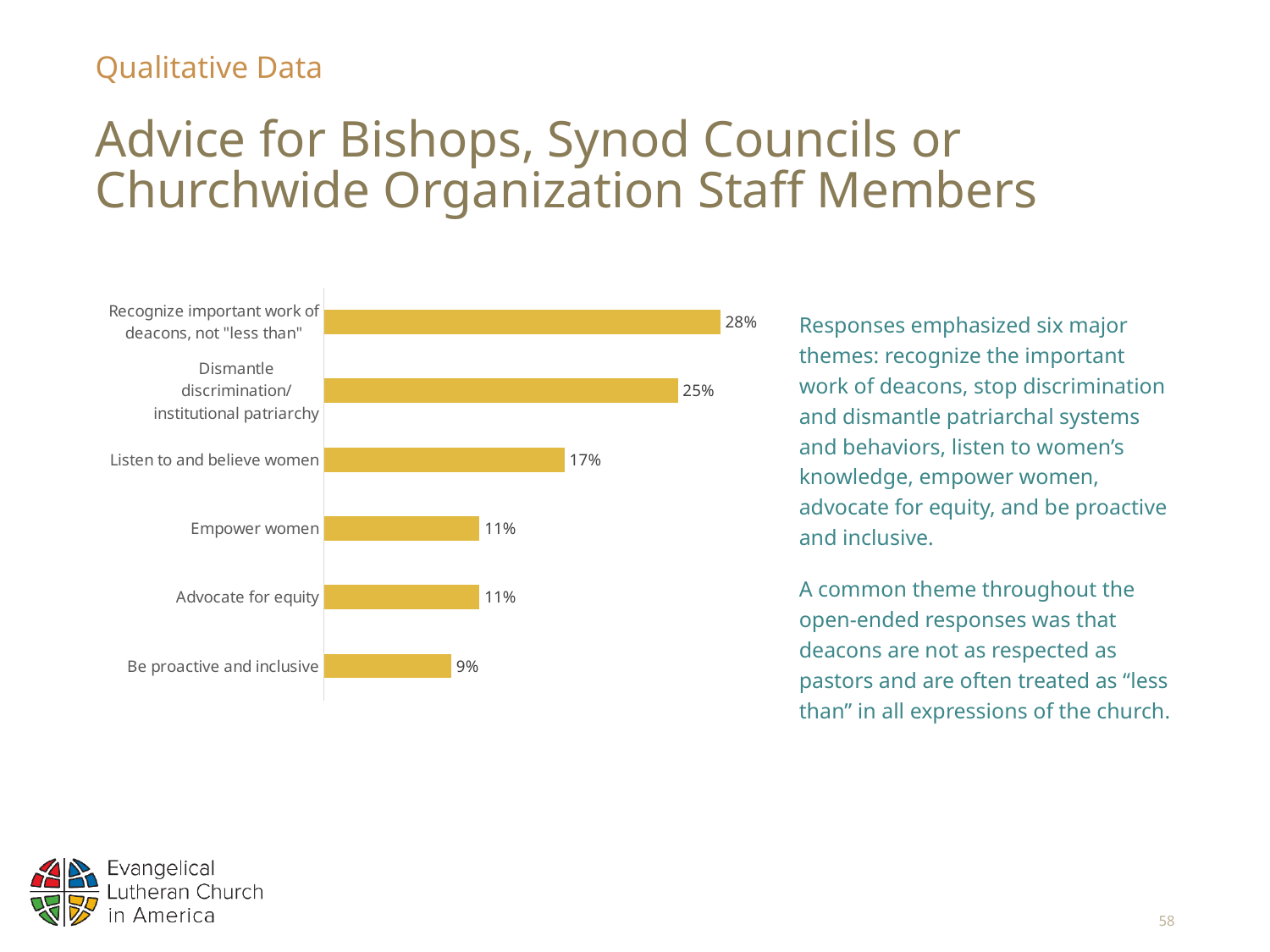
Which category has the lowest value? Be proactive and inclusive Which two categories share the same value of 11%? Empower women and Advocate for equity How many categories are shown in the chart? 6 Which category has the highest value? Recognize important work of deacons, not "less than" Which is larger, the value for "Listen to and believe women" or the value for "Advocate for equity"? Listen to and believe women What is the difference between the values for "Listen to and believe women" and "Empower women"? 6% What is the value for "Be proactive and inclusive"? 9% What percentage of responses advised to recognize the important work of deacons, not "less than"? 28% What is the value for "Dismantle discrimination/institutional patriarchy"? 25% What is the difference between the values for "Recognize important work of deacons, not 'less than'" and "Dismantle discrimination/institutional patriarchy"? 3% What kind of chart is shown on the slide? Bar chart What is the value for "Listen to and believe women"? 17%